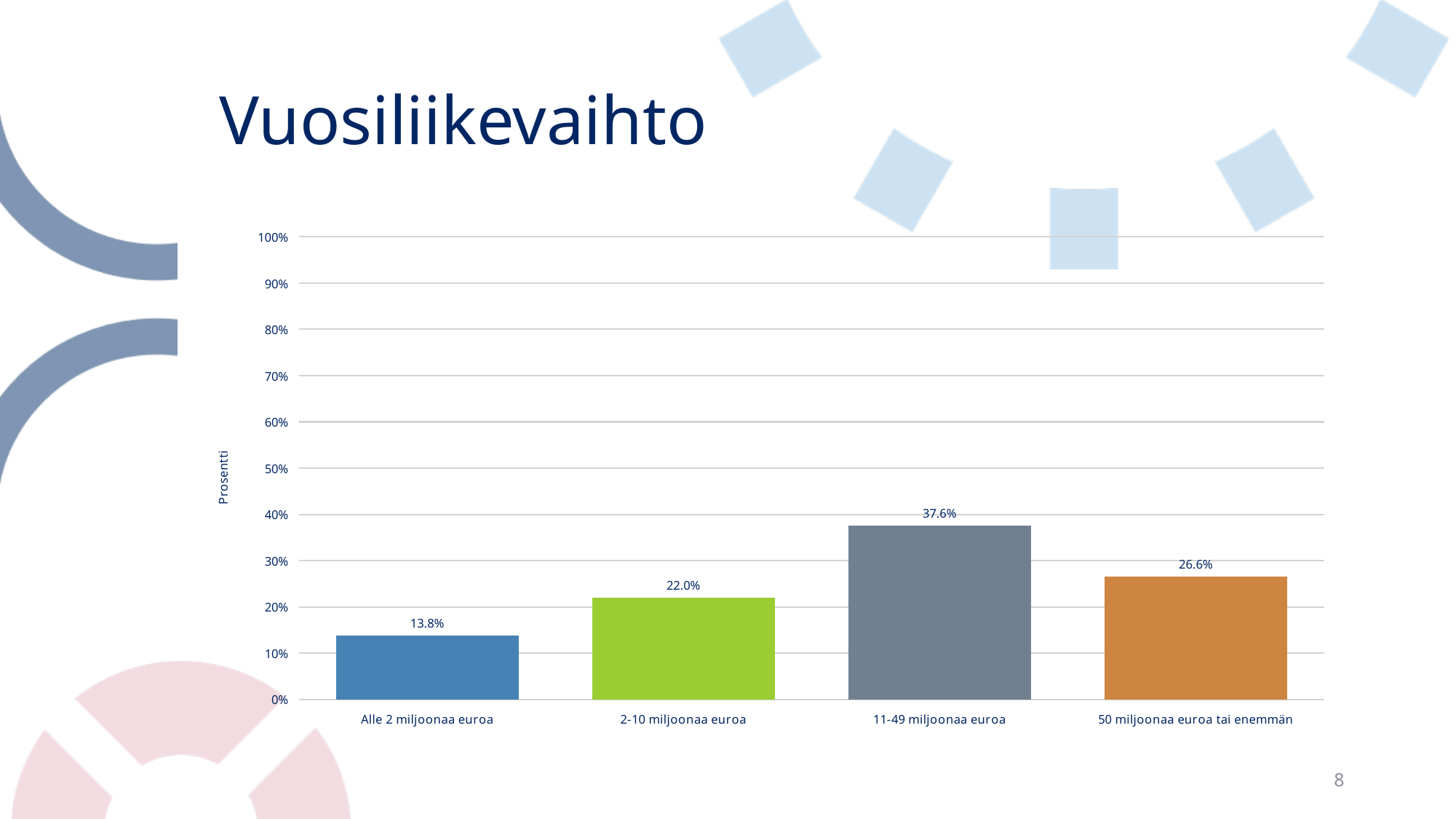
Which category has the lowest value? Alle 2 miljoonaa euroa How many categories are shown on the x axis? 4 Which is larger: the value for "2-10 miljoonaa euroa" or "50 miljoonaa euroa tai enemmän"? 50 miljoonaa euroa tai enemmän What is the value for "11-49 miljoonaa euroa"? 37.6% What is the title of the slide? Vuosiliikevaihto Which category has the highest value? 11-49 miljoonaa euroa What is the label of the y axis? Prosentti What kind of chart is shown on the slide? bar chart What is the difference between the values for "11-49 miljoonaa euroa" and "2-10 miljoonaa euroa"? 15.6% What is the value for "Alle 2 miljoonaa euroa"? 13.8% What is the value for "50 miljoonaa euroa tai enemmän"? 26.6% Is the value for "11-49 miljoonaa euroa" greater or less than 30%? greater